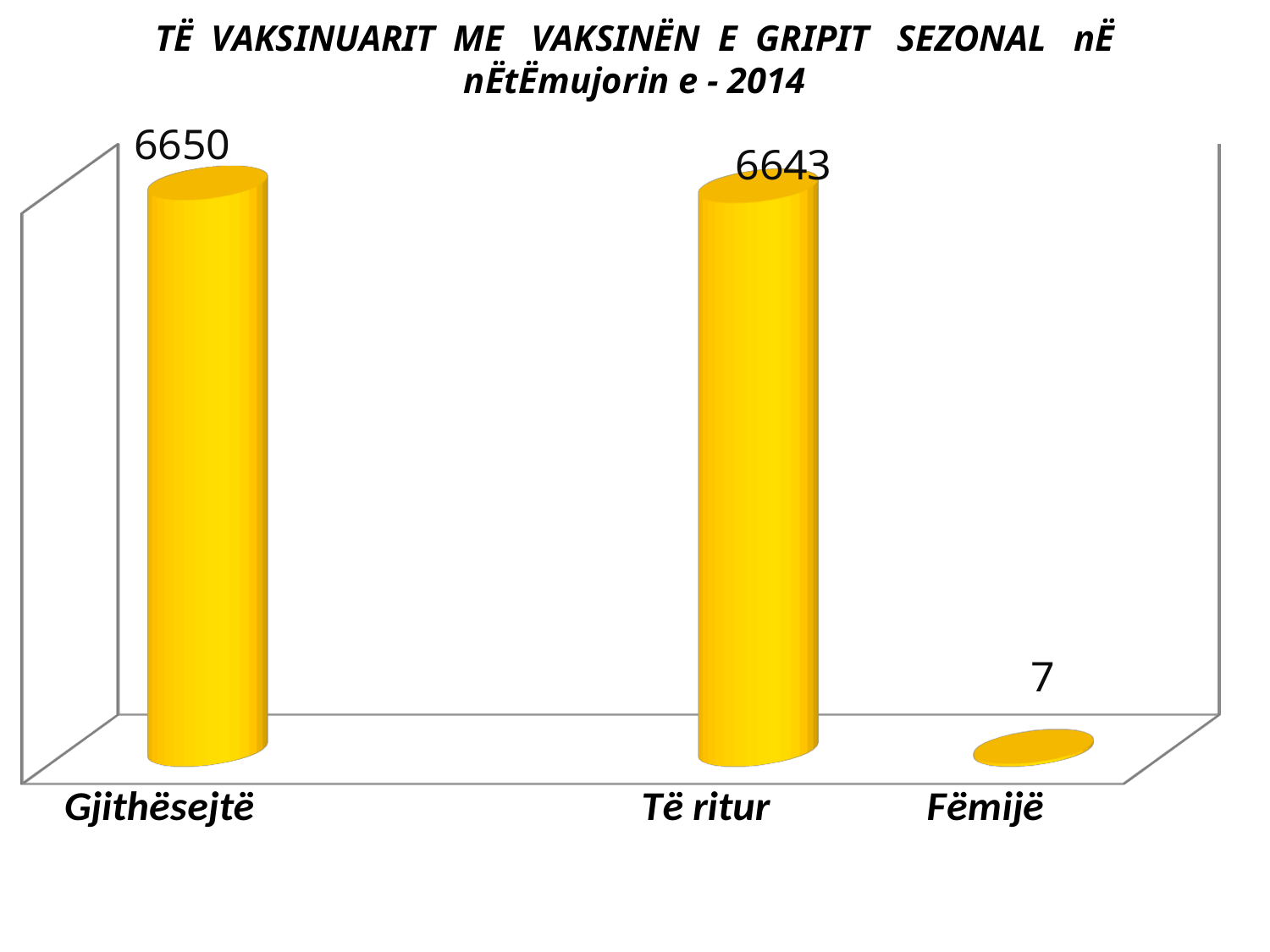
How many categories are shown on the chart? 3 Do the values rise or fall from left to right across the categories? Fall What is the value for Të ritur? 6643 What kind of chart is shown on the slide? Bar chart What year is mentioned in the chart title? 2014 Which category has the lowest value? Fëmijë What is the difference between the values for Gjithësejtë and Të ritur? 7 What colour are the bars in the chart? Yellow What is the value for Fëmijë? 7 What is the value for Gjithësejtë? 6650 Which is larger, the value for Të ritur or the value for Fëmijë? Të ritur What is the difference between the values for Të ritur and Fëmijë? 6636